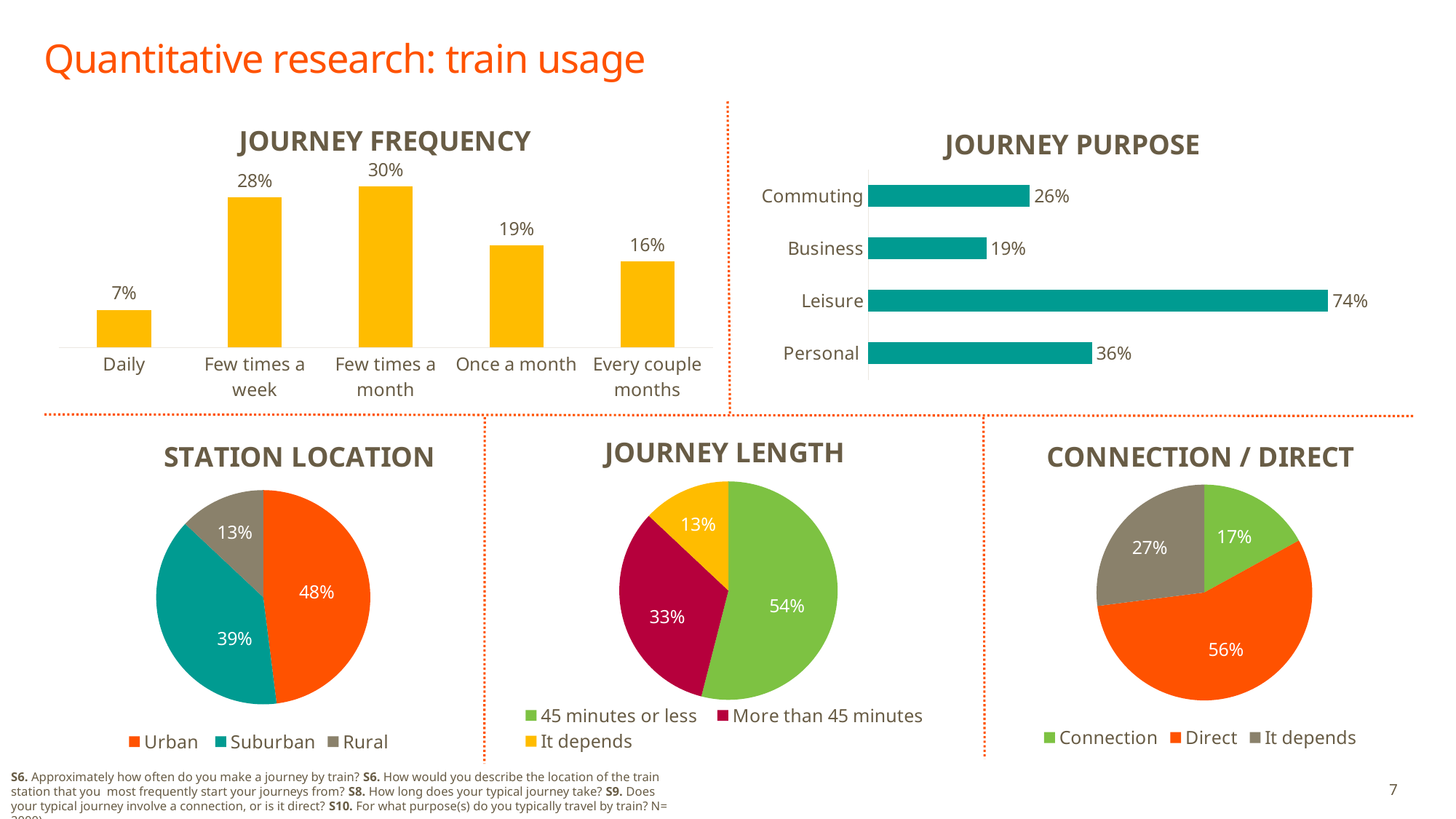
In the Station Location chart, what share of the pie is Suburban? 39% What kind of chart is the Journey Purpose chart? Bar chart In the Journey Length chart, what is the value for More than 45 minutes? 33% In the Journey Purpose chart, which is larger, Commuting or Business? Commuting In the Connection / Direct chart, which slice is the largest? Direct In the Journey Purpose chart, which category has the highest value? Leisure How many entries does the legend of the Journey Length chart list? 3 In the Journey Frequency chart, what is the difference between Few times a week and Once a month? 9% In the Journey Frequency chart, how many categories are shown? 5 In the Journey Purpose chart, what is the value for Personal? 36% In the Journey Frequency chart, which category has the lowest value? Daily In the Journey Frequency chart, what is the value for Few times a month? 30%